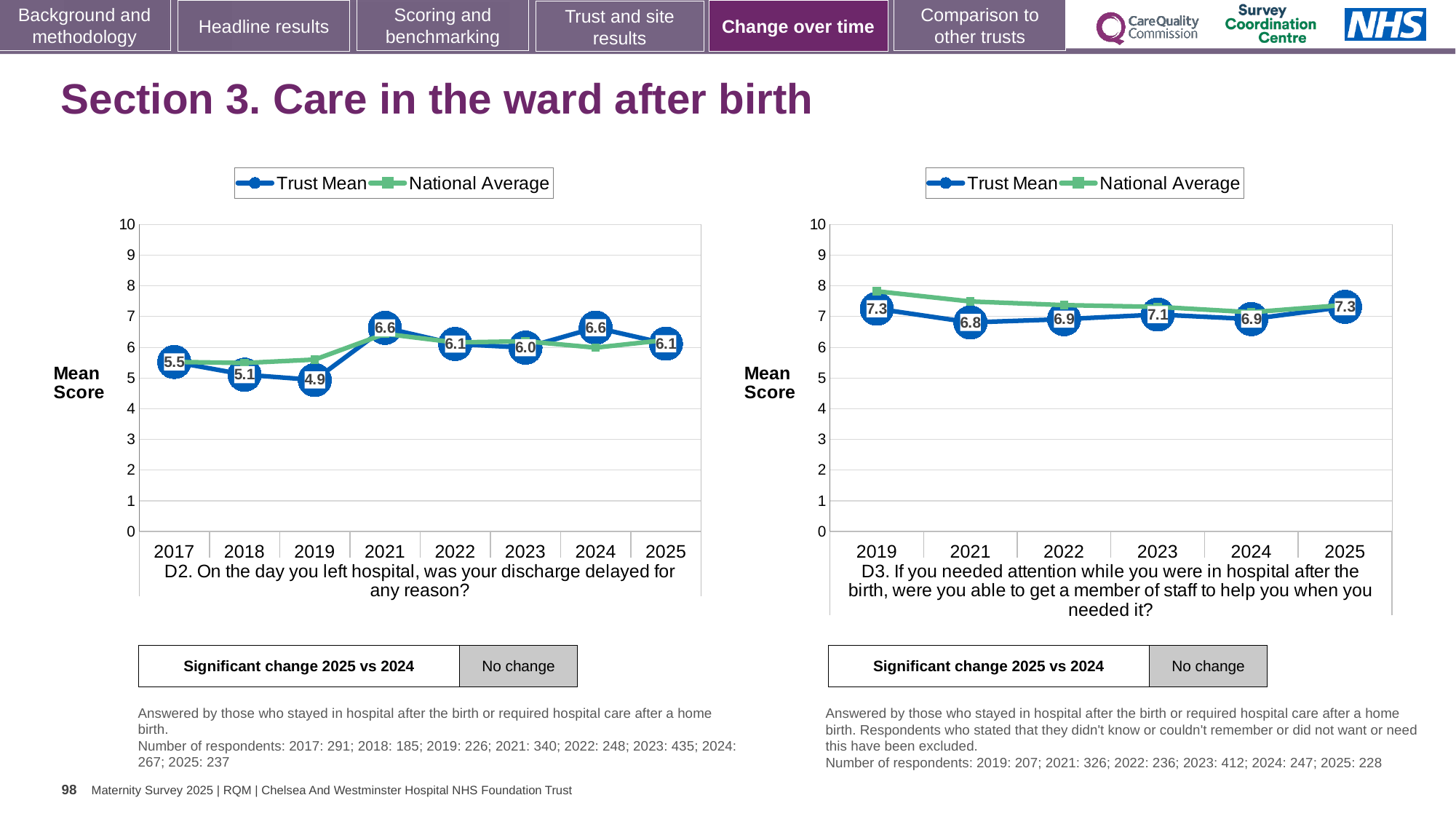
In the D3 chart (right), which year has the lowest Trust Mean score? 2021 How many series does the legend of the D3 chart (right) list? 2 In the D2 chart (left), what is the Trust Mean score for 2019? 4.9 In the D3 chart (right), what is the difference between the Trust Mean scores for 2025 and 2024? 0.4 In the D2 chart (left), which year has the lowest Trust Mean score? 2019 In the D2 chart (left), what is the Trust Mean score for 2025? 6.1 In the D2 chart (left), is the Trust Mean score higher in 2017 or in 2018? 2017 In the D3 chart (right), is the National Average value for 2019 greater or less than 7? greater In the D2 chart (left), how many years are plotted on the x axis? 8 In the D2 chart (left), is the National Average value for 2017 greater or less than 6? less In the D3 chart (right), what is the Trust Mean score for 2023? 7.1 In the D2 chart (left), what is the difference between the Trust Mean scores for 2021 and 2019? 1.7